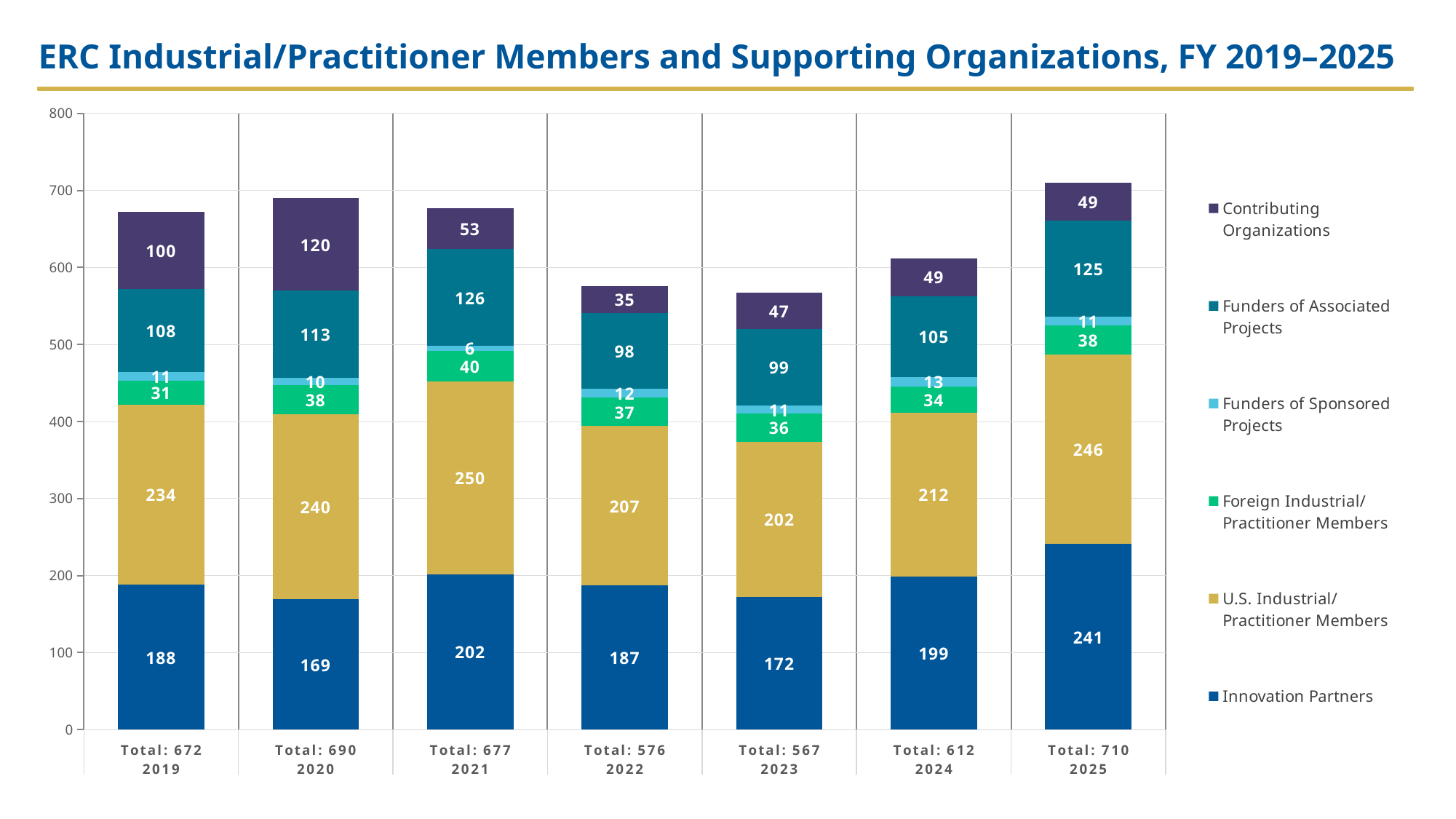
What is the value for Contributing Organizations in 2020? 120 Which is larger, Funders of Associated Projects in 2021 or in 2024? 2021 What is the total of the stacked bar for 2022? 576 What kind of chart is shown on the slide? Stacked bar chart How many series does the legend list? 6 Which year has the highest total? 2025 How many years are shown on the x axis? 7 What is the value for U.S. Industrial/Practitioner Members in 2021? 250 What is the value for Innovation Partners in 2025? 241 Which year has the lowest total? 2023 What is the value for Funders of Sponsored Projects in 2021? 6 What is the difference between the Innovation Partners values for 2025 and 2020? 72